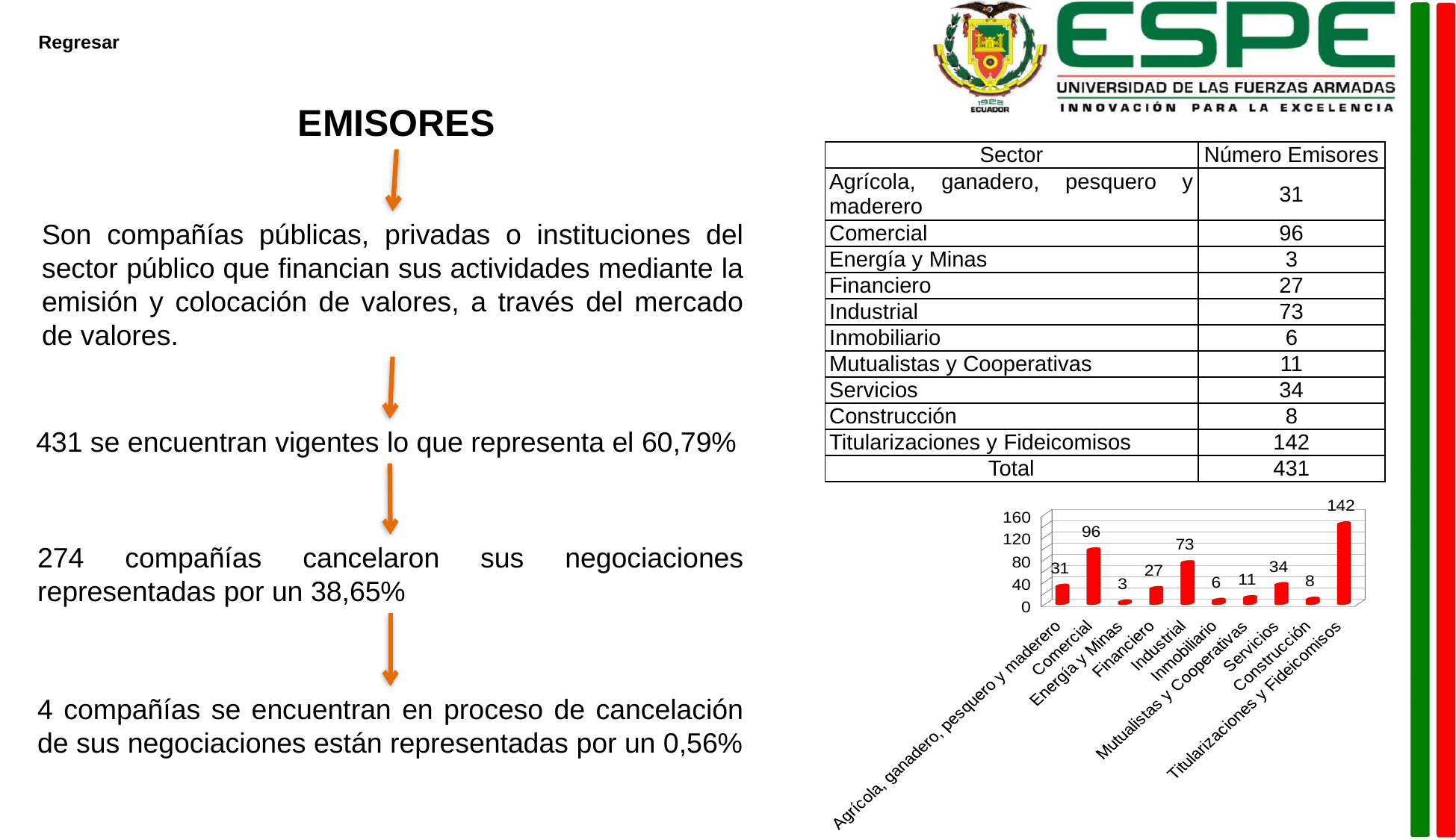
What is the value for Industrial in the bar chart? 73 Which is larger in the bar chart, Servicios or Financiero? Servicios What is the value for Mutualistas y Cooperativas in the bar chart? 11 What is the value for Energía y Minas in the bar chart? 3 Is the value for Industrial greater or less than 80? less What is the difference between the values for Titularizaciones y Fideicomisos and Comercial? 46 What type of chart is shown on the slide? bar chart What is the difference between the values for Servicios and Construcción? 26 How many categories are plotted in the bar chart? 10 Which category has the lowest value in the bar chart? Energía y Minas What is the value for Comercial in the bar chart? 96 Which category has the highest value in the bar chart? Titularizaciones y Fideicomisos